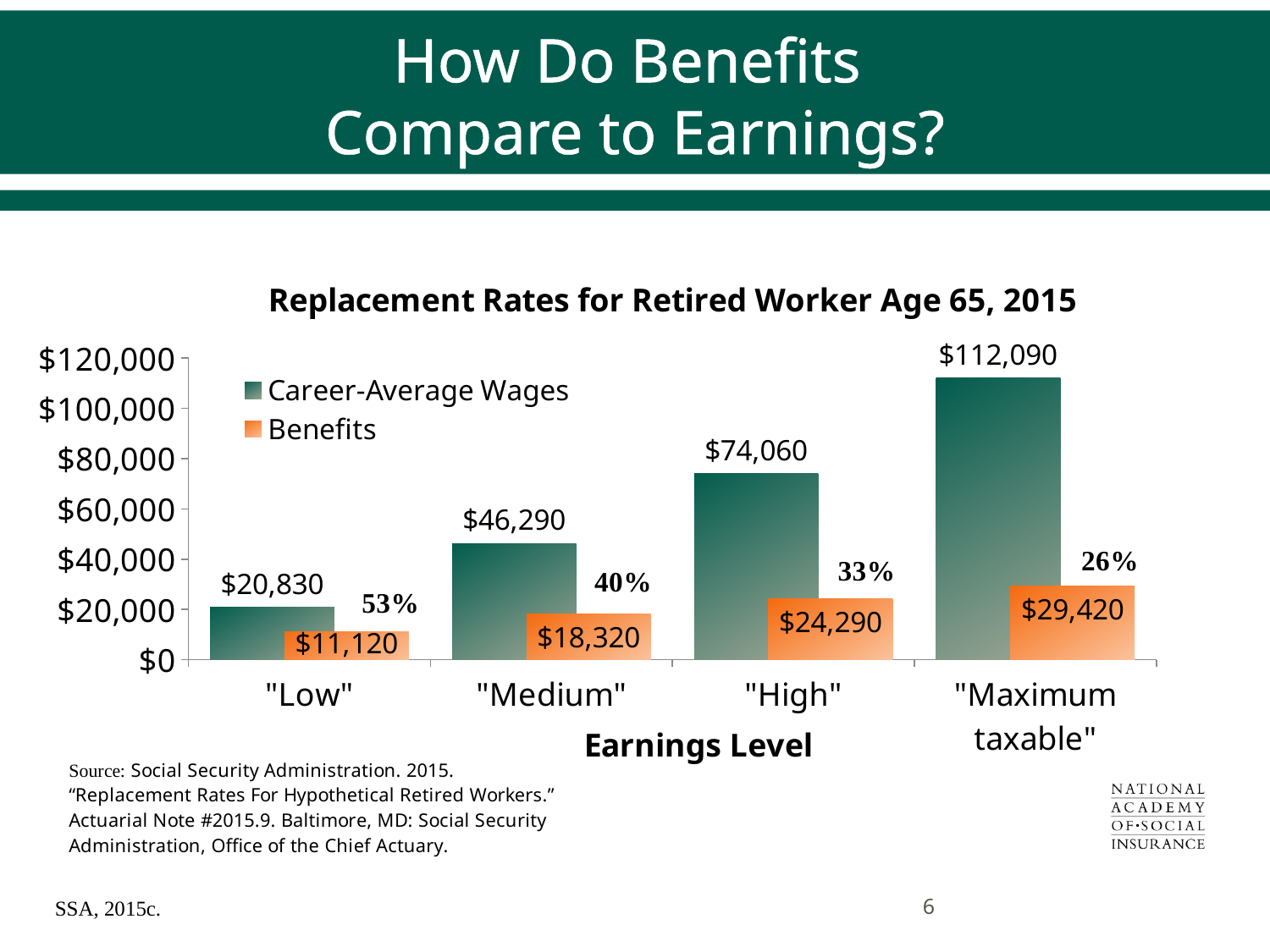
What kind of chart is shown on the slide? Bar chart How many series does the legend list? 2 What is the difference between Career-Average Wages and Benefits for the "High" earnings level? $49,770 Which earnings level has the highest Benefits value? "Maximum taxable" Which earnings level has the lowest Career-Average Wages value? "Low" What replacement rate percentage is shown for the "Low" earnings level? 53% What is the Benefits value for the "High" earnings level? $24,290 How many earnings levels are shown on the x axis? 4 What is the Career-Average Wages value for the "Medium" earnings level? $46,290 What is the Career-Average Wages value for the "Maximum taxable" earnings level? $112,090 What is the title of the chart? Replacement Rates for Retired Worker Age 65, 2015 Which is larger: Benefits for "Medium" or Benefits for "Low"? Benefits for "Medium"